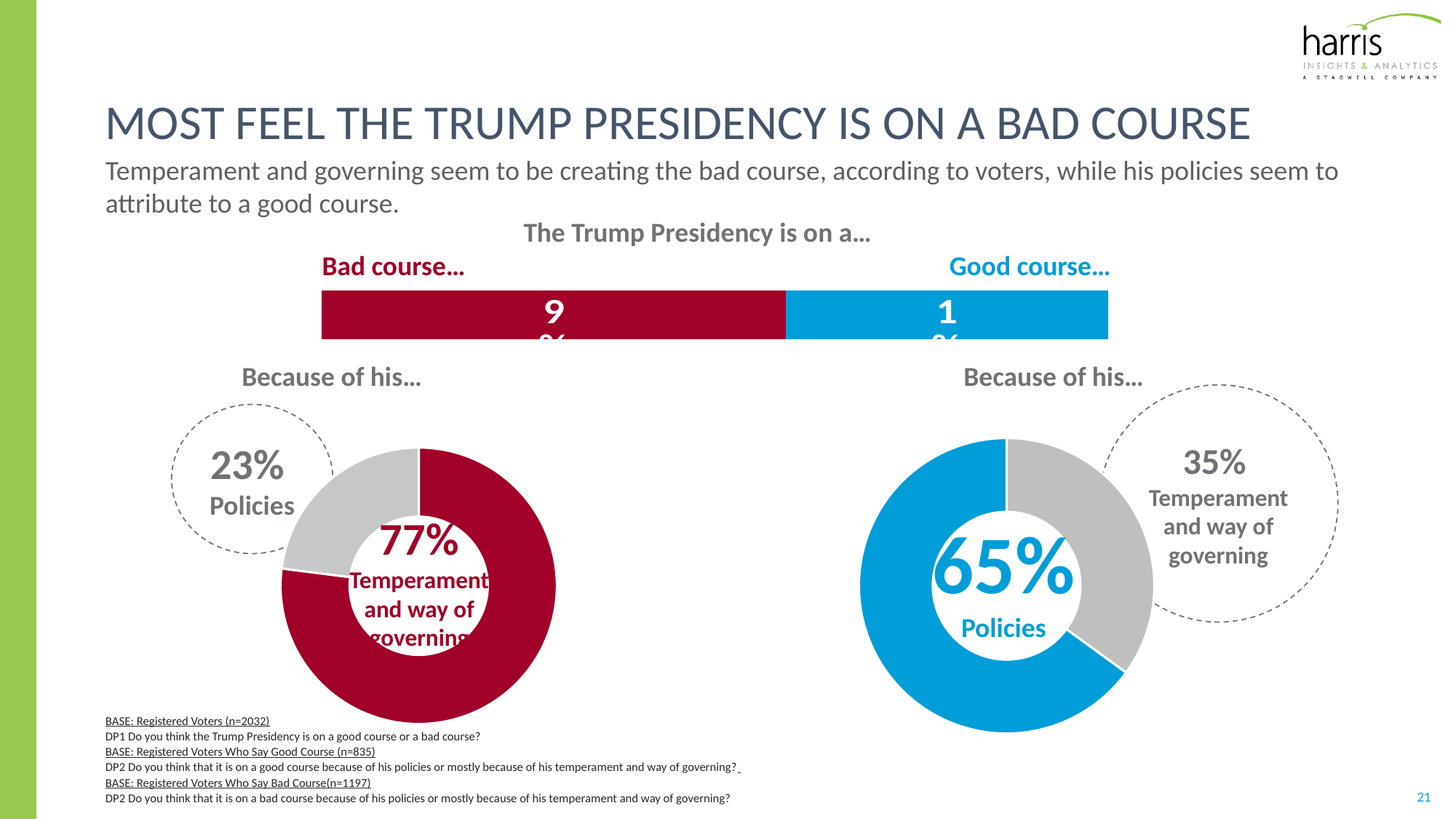
In the 'Because of his...' donut chart on the right (good course), what share is attributed to Policies? 65% In the 'Because of his...' donut chart on the left (bad course), what share is attributed to Policies? 23% In the 'The Trump Presidency is on a...' bar at the top, which segment is larger, Bad course or Good course? Bad course How many slices does each 'Because of his...' donut chart have? 2 What colour is the Good course segment in the top bar? Blue In the 'Because of his...' donut chart on the left (bad course), what share is attributed to Temperament and way of governing? 77% In the left donut chart (bad course), what is the difference between the Temperament and way of governing share and the Policies share? 54 percentage points In the 'Because of his...' donut chart on the right (good course), what share is attributed to Temperament and way of governing? 35% In the right donut chart (good course), what is the difference between the Policies share and the Temperament and way of governing share? 30 percentage points In the left donut chart (bad course), which reason has the largest share? Temperament and way of governing In the right donut chart (good course), which reason has the smallest share? Temperament and way of governing What kind of chart is used for the two 'Because of his...' breakdowns? Donut (pie) chart